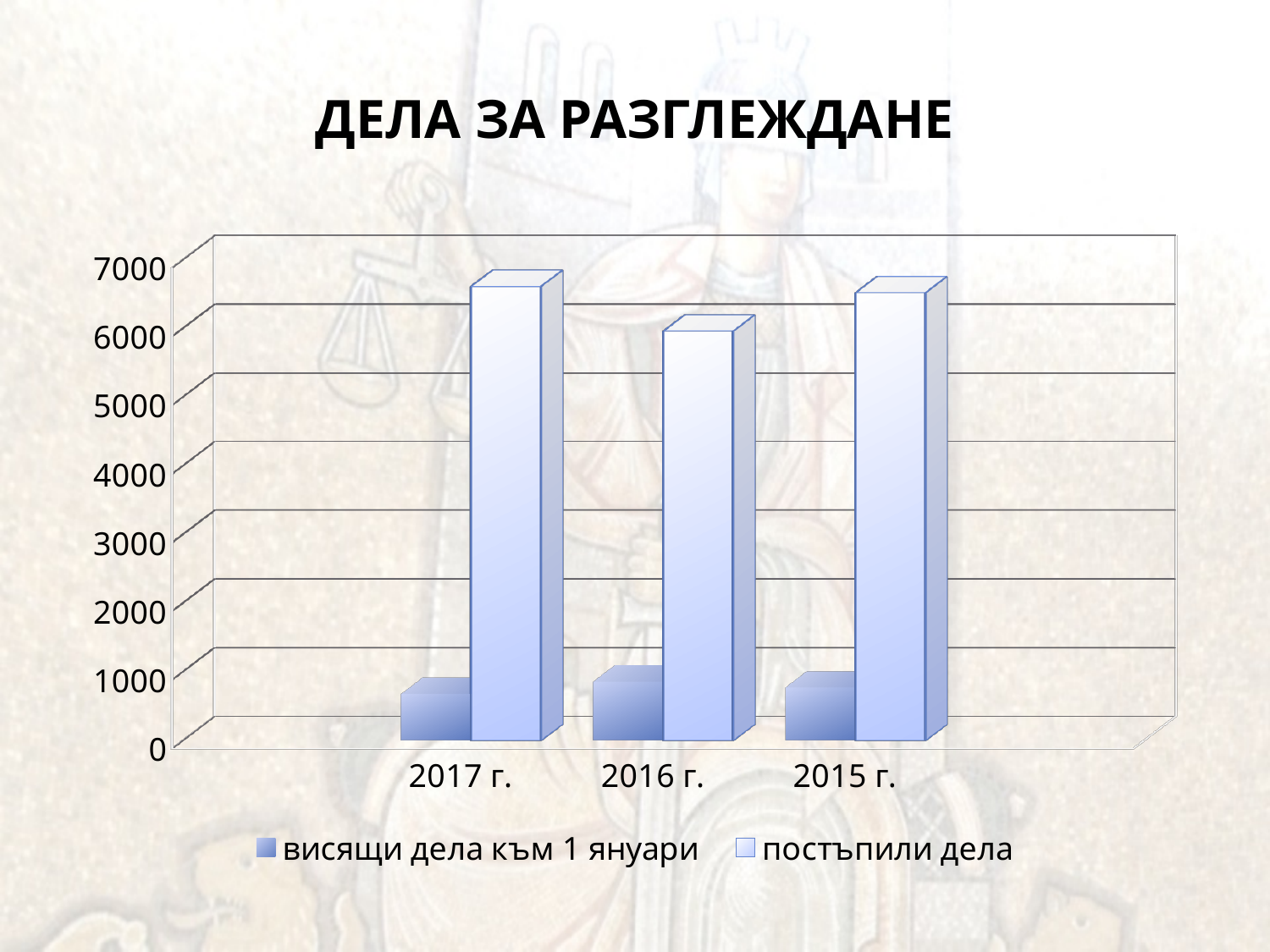
How many series does the legend list? 2 Is the value for постъпили дела in 2017 г. greater or less than 6000? greater Which year has the lowest value for постъпили дела? 2016 г. Is the value for висящи дела към 1 януари in 2017 г. greater or less than 1000? less What kind of chart is shown on the slide? bar chart Is the value for постъпили дела in 2015 г. greater or less than 6000? greater How many categories are shown on the x axis? 3 Which series is shown in the lighter blue colour? постъпили дела What is the title of the chart? ДЕЛА ЗА РАЗГЛЕЖДАНЕ In 2017 г., which is larger: висящи дела към 1 януари or постъпили дела? постъпили дела